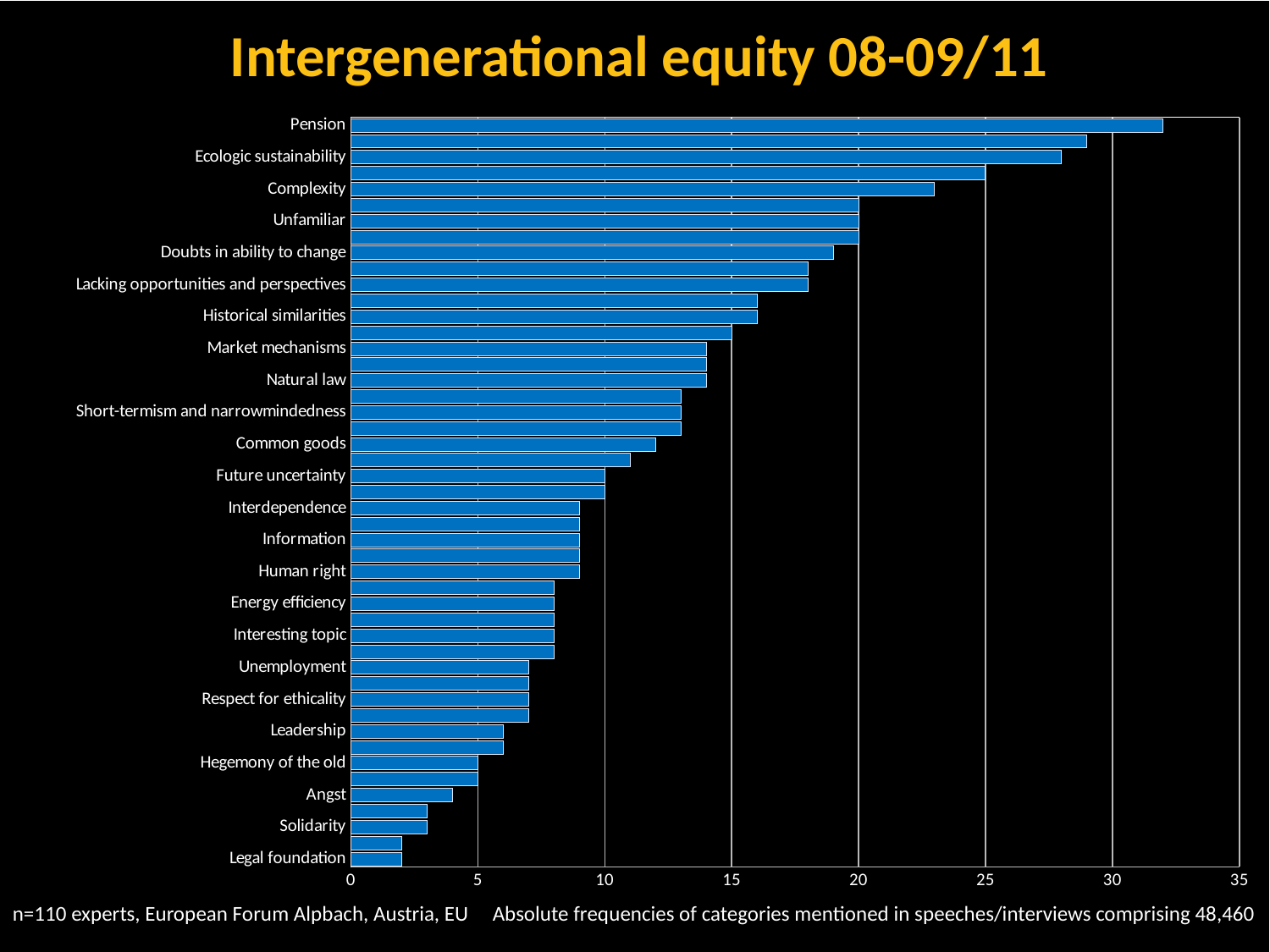
What is the title of the chart? Intergenerational equity 08-09/11 What is the value for Hegemony of the old? 5 Is the value for Pension greater or less than 30? greater What kind of chart is shown on the slide? bar chart Do the bar values increase or decrease going from the top of the chart to the bottom? decrease Is the value for Ecologic sustainability greater or less than 25? greater Which category has the highest value? Pension Which category has the lowest value? Legal foundation What is the value for Future uncertainty? 10 What is the value for Unfamiliar? 20 Is the value for Legal foundation greater or less than 5? less Which is larger, the value for Complexity or the value for Angst? Complexity